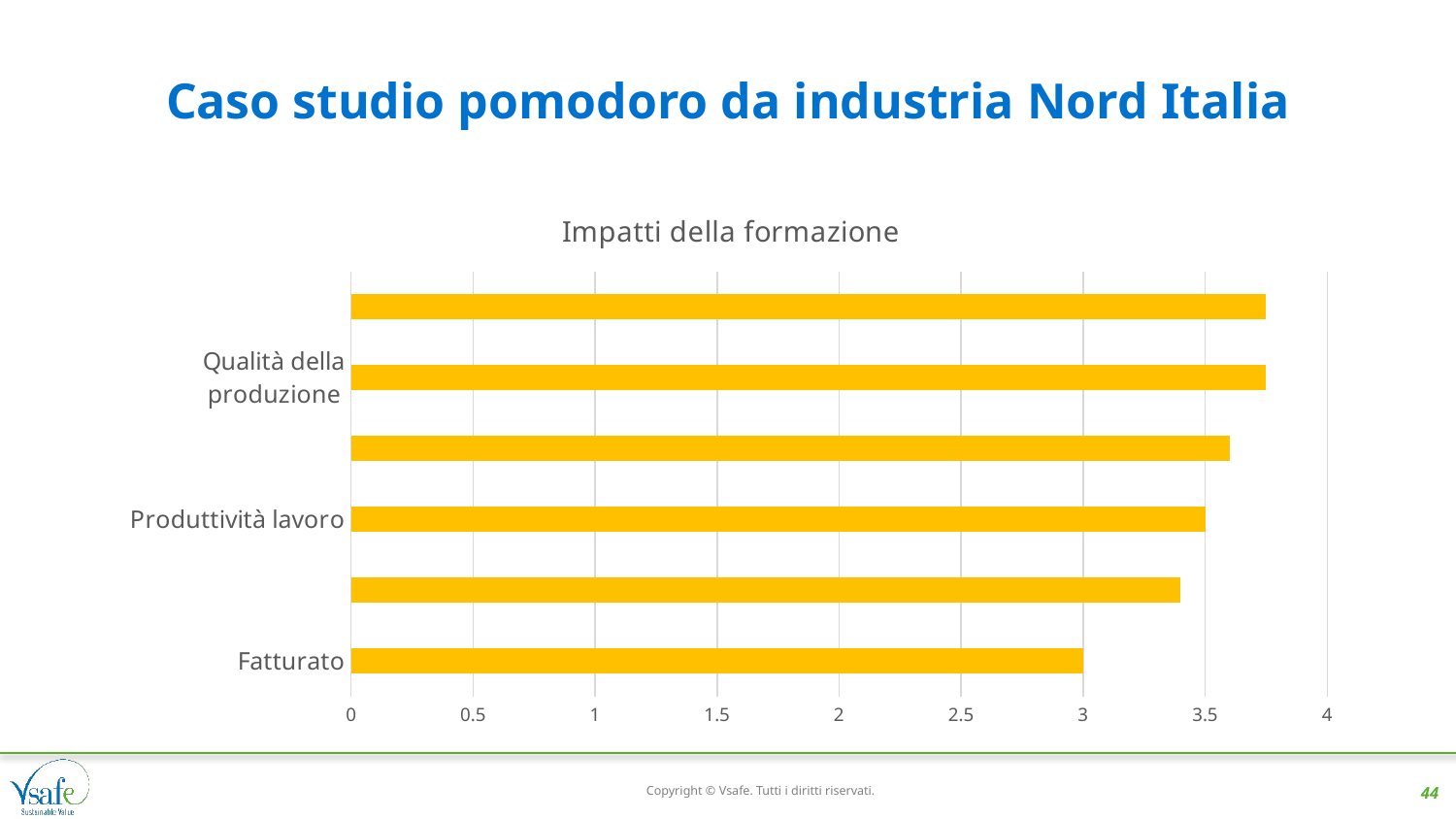
How many bars are plotted in the chart? 6 Is the value for Qualità della produzione greater or less than 3.5? greater What is the maximum value shown on the horizontal axis? 4 Which labelled category has the lowest value? Fatturato Is the value for Fatturato greater or less than 3.5? less What is the value for Fatturato? 3 Which is larger, the value for Qualità della produzione or the value for Fatturato? Qualità della produzione What colour are the bars in the chart? yellow What is the difference between the values for Produttività lavoro and Fatturato? 0.5 What is the value for Produttività lavoro? 3.5 What is the title of the chart? Impatti della formazione What kind of chart is shown on the slide? bar chart